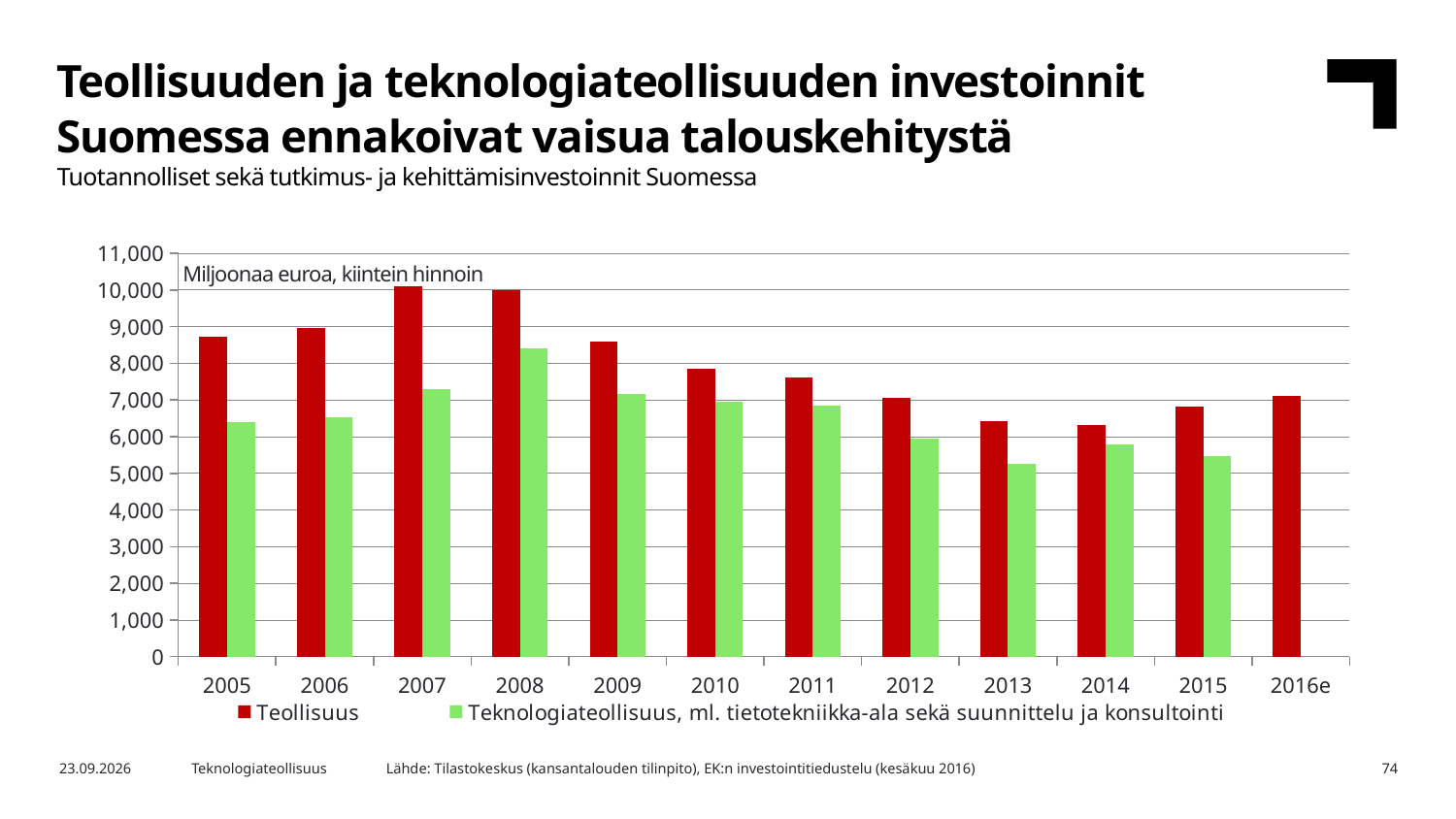
How many series does the legend list? 2 In which year is the Teknologiateollisuus value lowest? 2013 What kind of chart is shown on the slide? Bar chart Is the Teknologiateollisuus value for 2013 greater or less than 6,000? less In which year is the Teknologiateollisuus value highest? 2008 Is the Teollisuus value for 2005 greater or less than 8,000? greater What unit is stated in the label inside the chart area? Miljoonaa euroa, kiintein hinnoin Is the Teollisuus value for 2010 greater or less than 8,000? less How many years are shown on the x axis? 12 In 2008, which series has the larger value, Teollisuus or Teknologiateollisuus? Teollisuus Does the Teollisuus value rise or fall from 2008 to 2014? Fall